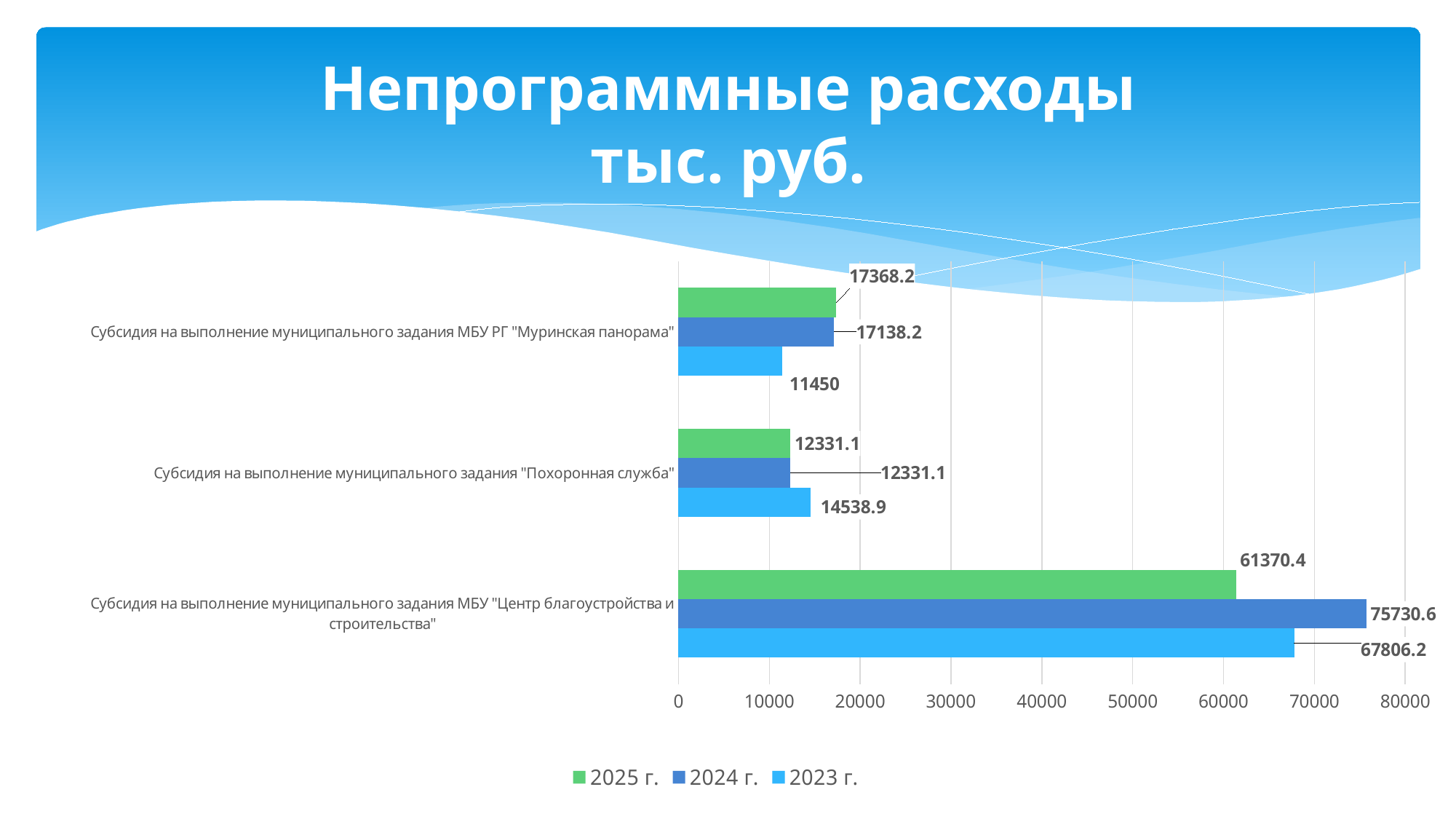
What is the title of the slide? Непрограммные расходы тыс. руб. What is the 2023 г. value for Субсидия на выполнение муниципального задания "Похоронная служба"? 14538.9 What is the 2025 г. value for Субсидия на выполнение муниципального задания МБУ РГ "Муринская панорама"? 17368.2 Which category has the lowest 2023 г. value? Субсидия на выполнение муниципального задания МБУ РГ "Муринская панорама" Which category has the highest 2024 г. value? Субсидия на выполнение муниципального задания МБУ "Центр благоустройства и строительства" What is the 2024 г. value for Субсидия на выполнение муниципального задания МБУ "Центр благоустройства и строительства"? 75730.6 Is the 2023 г. value for Субсидия на выполнение муниципального задания МБУ "Центр благоустройства и строительства" greater or less than 60000? greater What kind of chart is shown on the slide? bar chart How many categories are shown on the chart? 3 How many series does the legend list? 3 For Субсидия на выполнение муниципального задания МБУ РГ "Муринская панорама", which is larger: the 2023 г. value or the 2024 г. value? 2024 г. What is the difference between the 2024 г. and 2025 г. values for Субсидия на выполнение муниципального задания МБУ "Центр благоустройства и строительства"? 14360.2